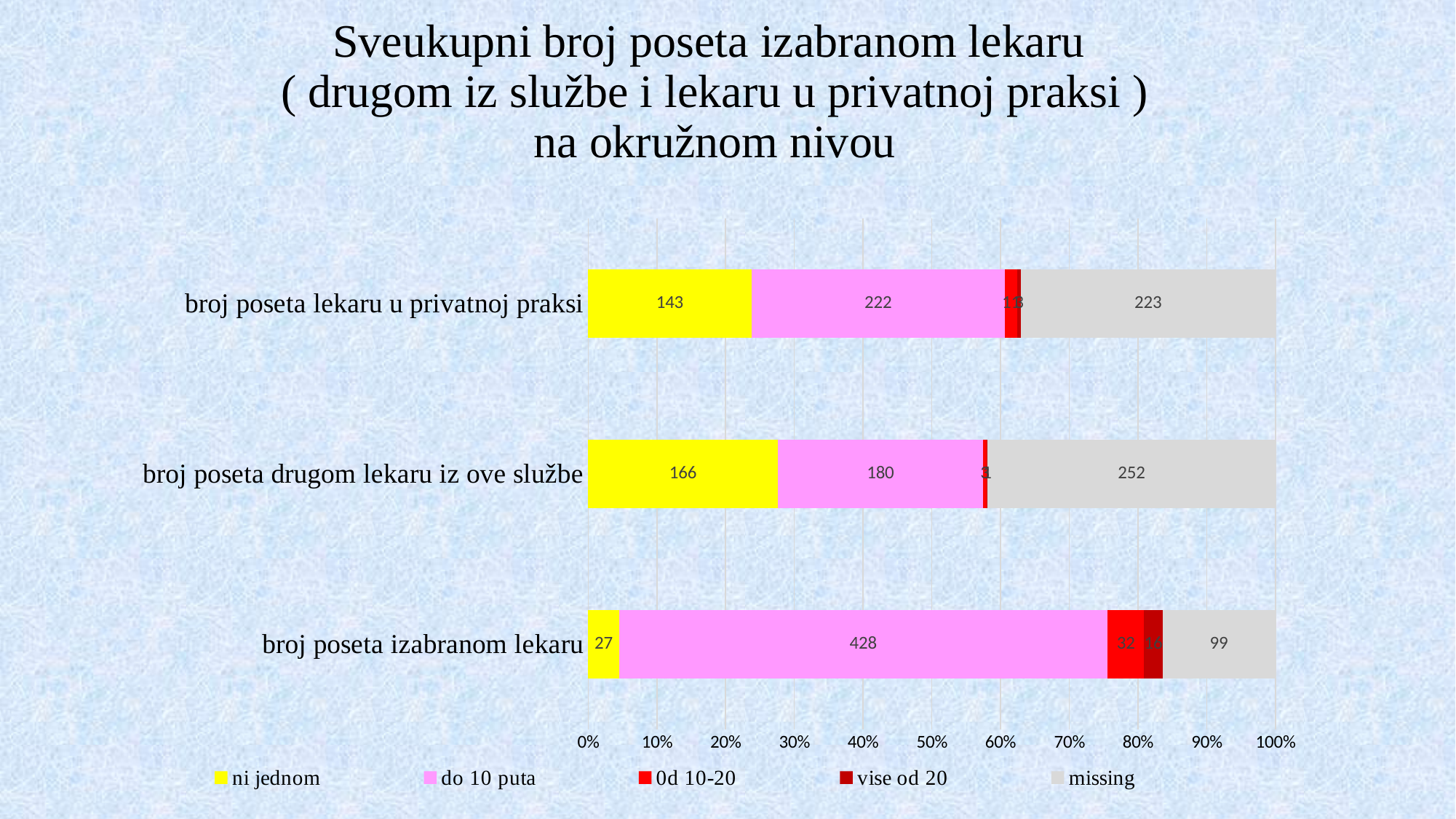
How many series does the legend list? 5 How many categories (bars) does the chart show? 3 What is the value of 'do 10 puta' for 'broj poseta izabranom lekaru'? 428 What is the value of 'ni jednom' for 'broj poseta lekaru u privatnoj praksi'? 143 Which category has the lowest 'missing' value? broj poseta izabranom lekaru Which legend entry is shown in yellow? ni jednom Which category has the highest 'ni jednom' value? broj poseta drugom lekaru iz ove službe Which is larger: the 'do 10 puta' value for 'broj poseta lekaru u privatnoj praksi' or for 'broj poseta drugom lekaru iz ove službe'? broj poseta lekaru u privatnoj praksi What kind of chart is shown on the slide? stacked bar chart What is the value of 'missing' for 'broj poseta drugom lekaru iz ove službe'? 252 What is the difference between the 'missing' values for 'broj poseta drugom lekaru iz ove službe' and 'broj poseta lekaru u privatnoj praksi'? 29 What is the value of 'vise od 20' for 'broj poseta izabranom lekaru'? 16